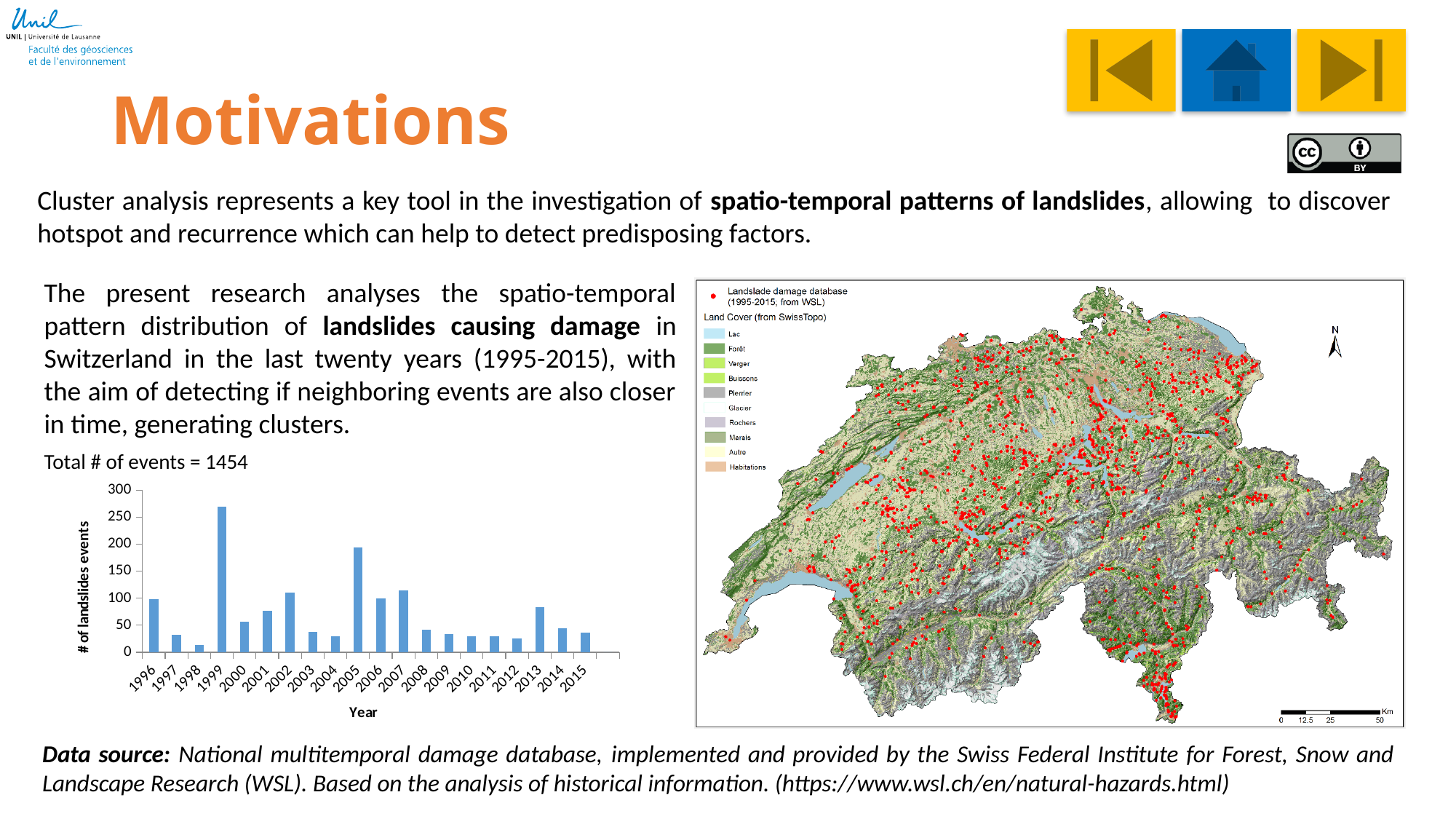
What kind of chart is shown on the slide? bar chart Which year has the lowest number of landslide events? 1998 How many years are shown on the x axis of the bar chart? 20 Is the number of landslide events in 1998 greater or less than 50? less Which year has more landslide events, 1999 or 2005? 1999 Is the number of landslide events in 2013 greater or less than 100? less From 2008 to 2012, do the number of landslide events rise or fall? fall Is the number of landslide events in 1999 greater or less than 250? greater Which year has the highest number of landslide events? 1999 What is the label of the y axis of the bar chart? # of landslides events Which year has more landslide events, 2013 or 2014? 2013